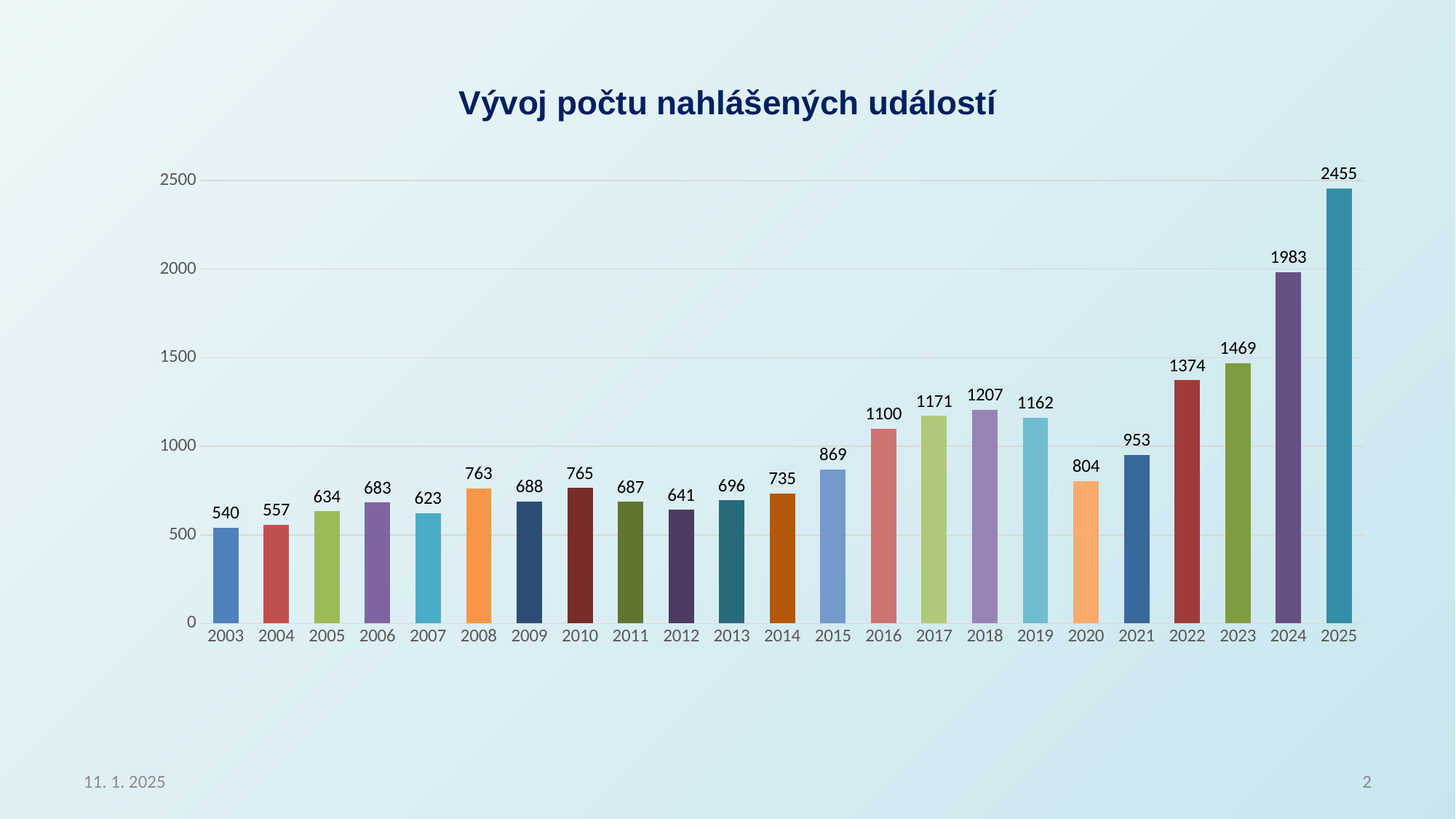
What is the title of the chart? Vývoj počtu nahlášených událostí What is the difference between the values for 2020 and 2019? 358 Do the values generally rise or fall from 2003 to 2025? rise What is the value for 2020? 804 Which year has the lowest value? 2003 Which is larger, the value for 2018 or the value for 2019? 2018 Is the value for 2022 greater or less than 1500? less What is the difference between the values for 2025 and 2024? 472 What kind of chart is shown on the slide? bar chart What is the value for 2015? 869 How many years are shown on the x axis? 23 Which year has the highest value? 2025